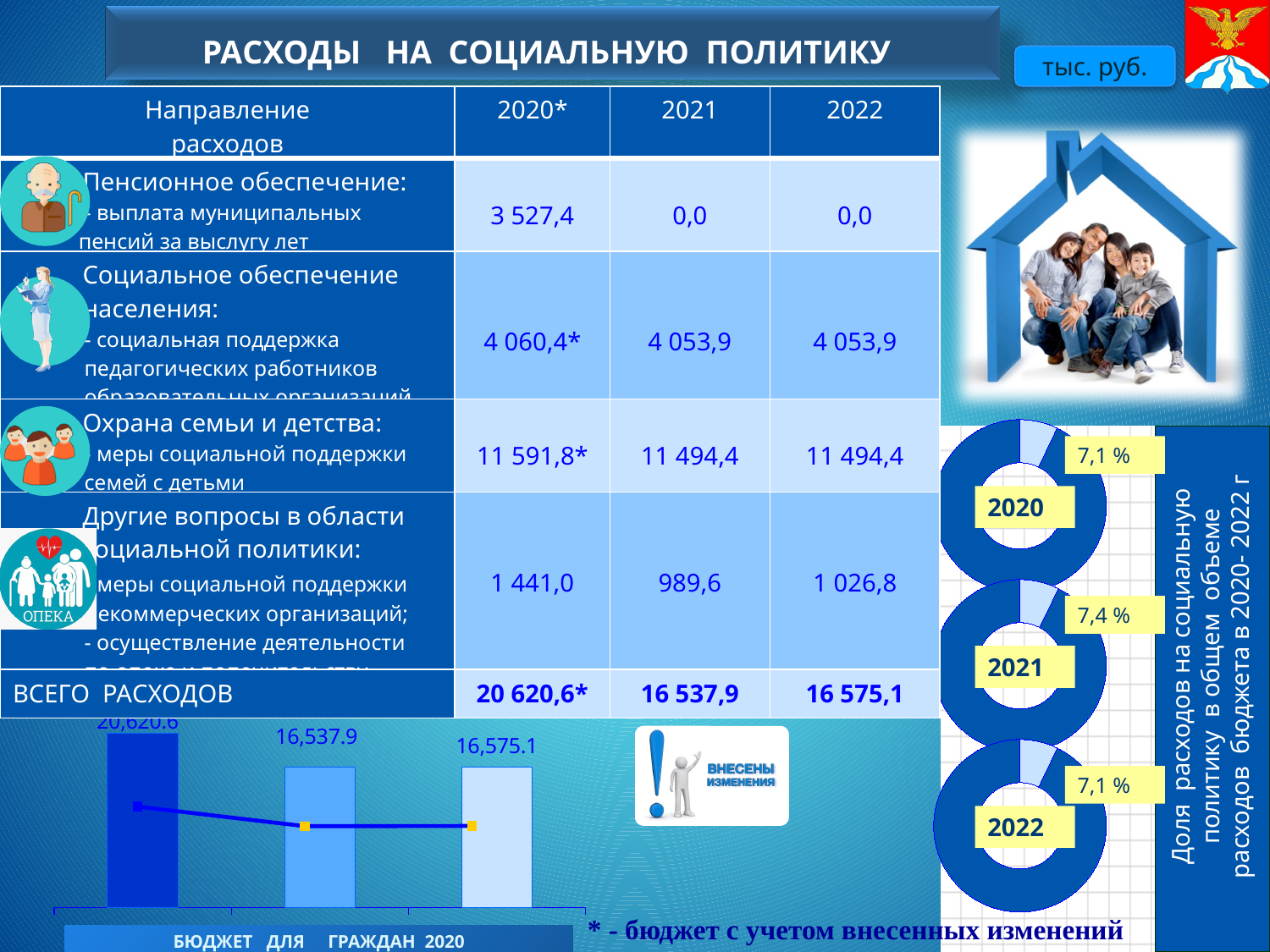
What type of chart is shown at the bottom left of the slide? bar chart In the donut charts on the right, what share is shown for 2022? 7,1 % In the donut charts on the right, which year has the highest share? 2021 In the bar chart at the bottom left, what is the value shown on the third bar? 16,575.1 In the bar chart at the bottom left, which bar is the tallest: the first, second or third? the first In the bar chart at the bottom left, which bar is the lowest: the first, second or third? the second In the bar chart at the bottom left, what is the difference between the third bar (16,575.1) and the second bar (16,537.9)? 37.2 In the donut charts on the right, what share is shown for 2021? 7,4 % In the bar chart at the bottom left, what is the value shown on the first (leftmost) bar? 20,620.6 In the bar chart at the bottom left, how many bars are plotted? 3 In the bar chart at the bottom left, what is the value shown on the second bar? 16,537.9 How many donut charts are shown on the right side of the slide? 3